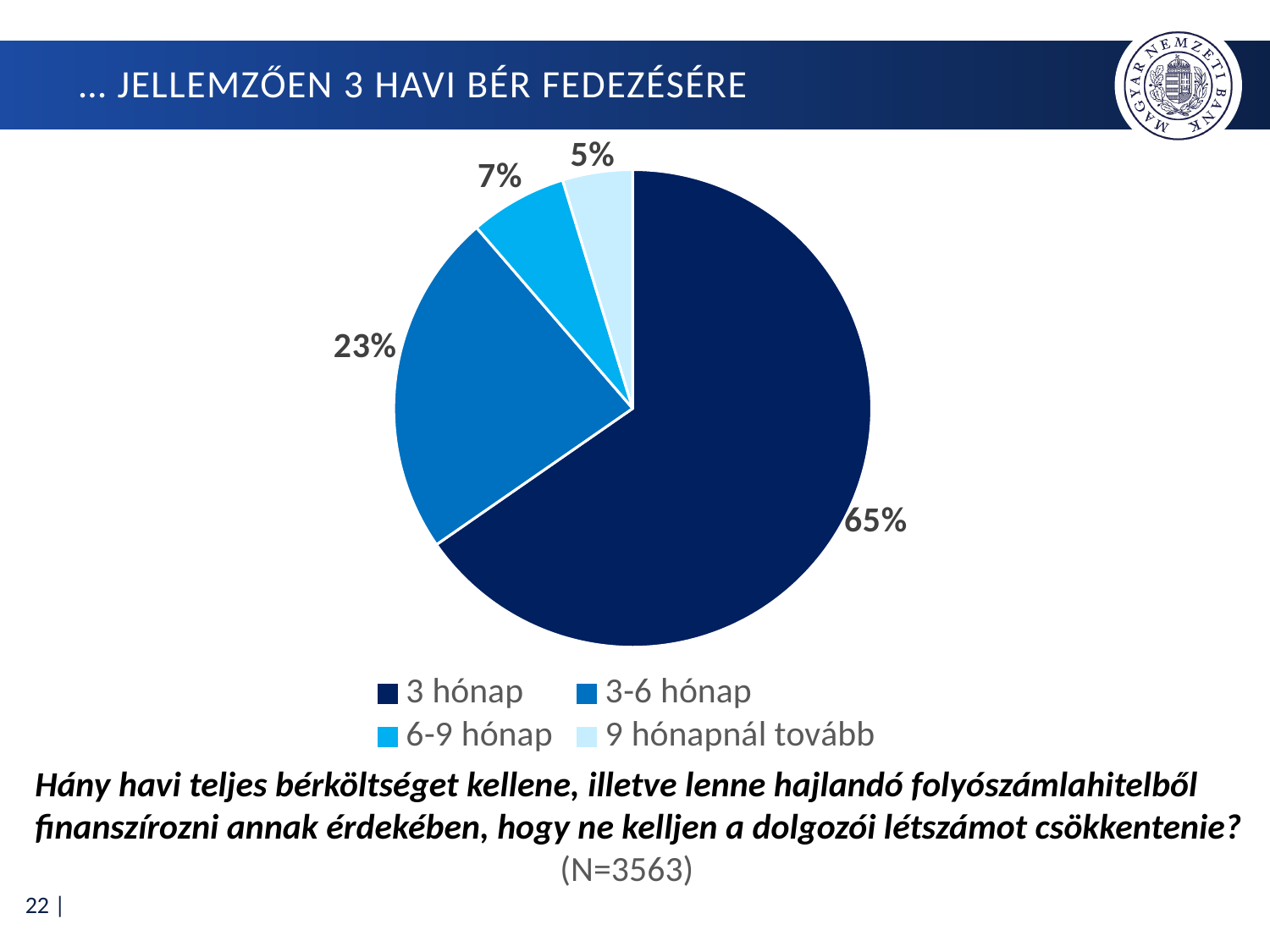
What share of the pie does the "3-6 hónap" slice represent? 23% What kind of chart is shown on the slide? pie chart What is the difference in percentage points between the "3 hónap" and "3-6 hónap" slices? 42 Which category has the largest slice of the pie? 3 hónap What share of the pie does the "3 hónap" slice represent? 65% What is the sample size (N) stated below the chart? N=3563 What share of the pie does the "6-9 hónap" slice represent? 7% Which category has the smallest slice of the pie? 9 hónapnál tovább Which slice is larger, "6-9 hónap" or "9 hónapnál tovább"? 6-9 hónap How many entries does the legend list? 4 What share of the pie does the "9 hónapnál tovább" slice represent? 5% How many categories does the pie chart show? 4